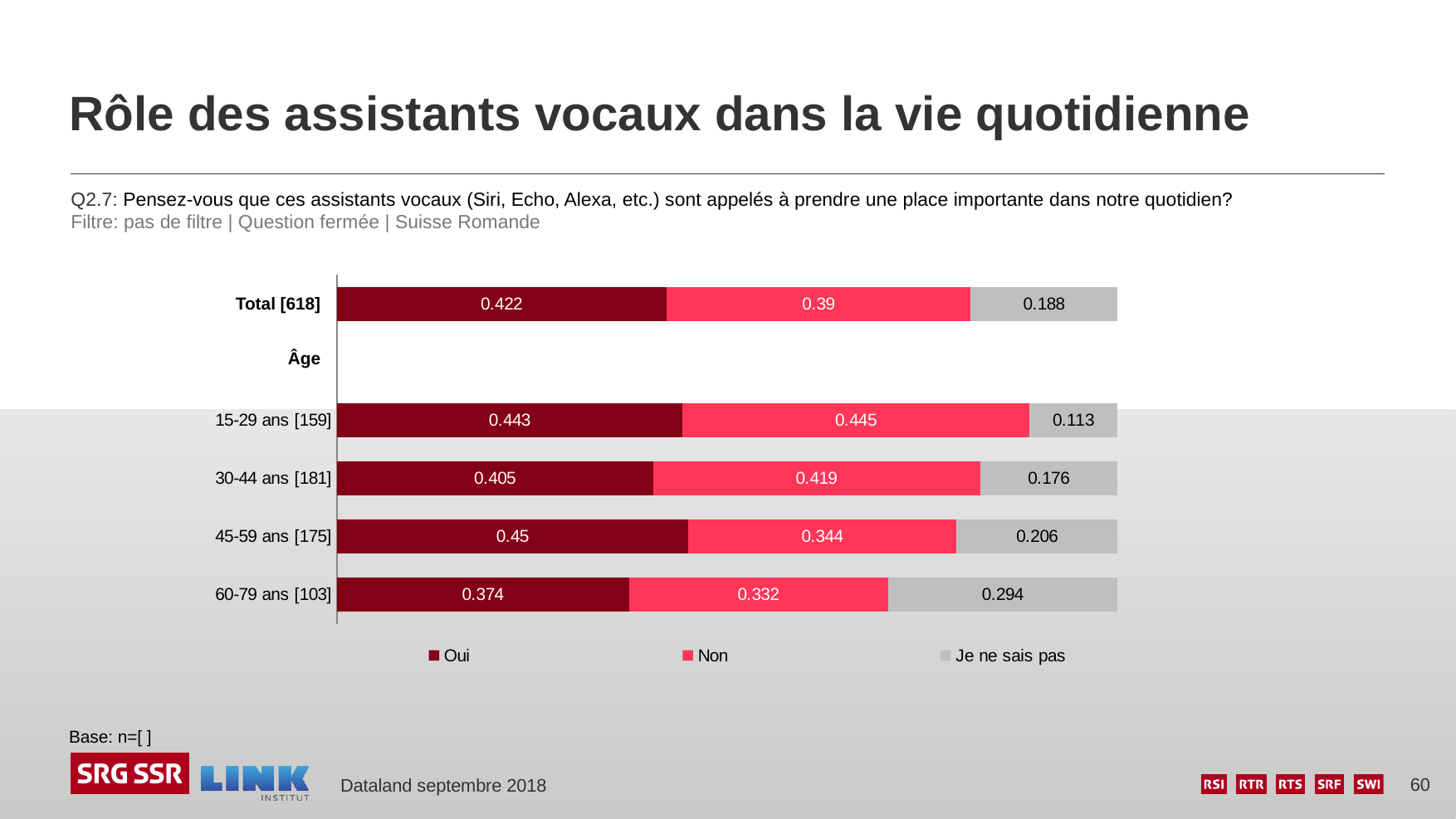
What is the 'Oui' value for the 45-59 ans [175] category? 0.45 What is the total of the three segments in the 60-79 ans [103] bar? 1 What is the 'Non' value for the 30-44 ans [181] category? 0.419 Which age category has the highest 'Je ne sais pas' value? 60-79 ans [103] Which age category has the lowest 'Oui' value? 60-79 ans [103] Which legend entry is shown in dark red? Oui What is the difference between the 'Oui' value for 45-59 ans [175] and the 'Oui' value for 60-79 ans [103]? 0.076 What kind of chart is shown on the slide? Stacked bar chart How many age categories (excluding Total) are plotted in the chart? 4 How many series does the legend list? 3 Which is larger: the 'Non' value for 15-29 ans [159] or the 'Non' value for 45-59 ans [175]? 15-29 ans [159] What is the 'Je ne sais pas' value for the Total [618] bar? 0.188